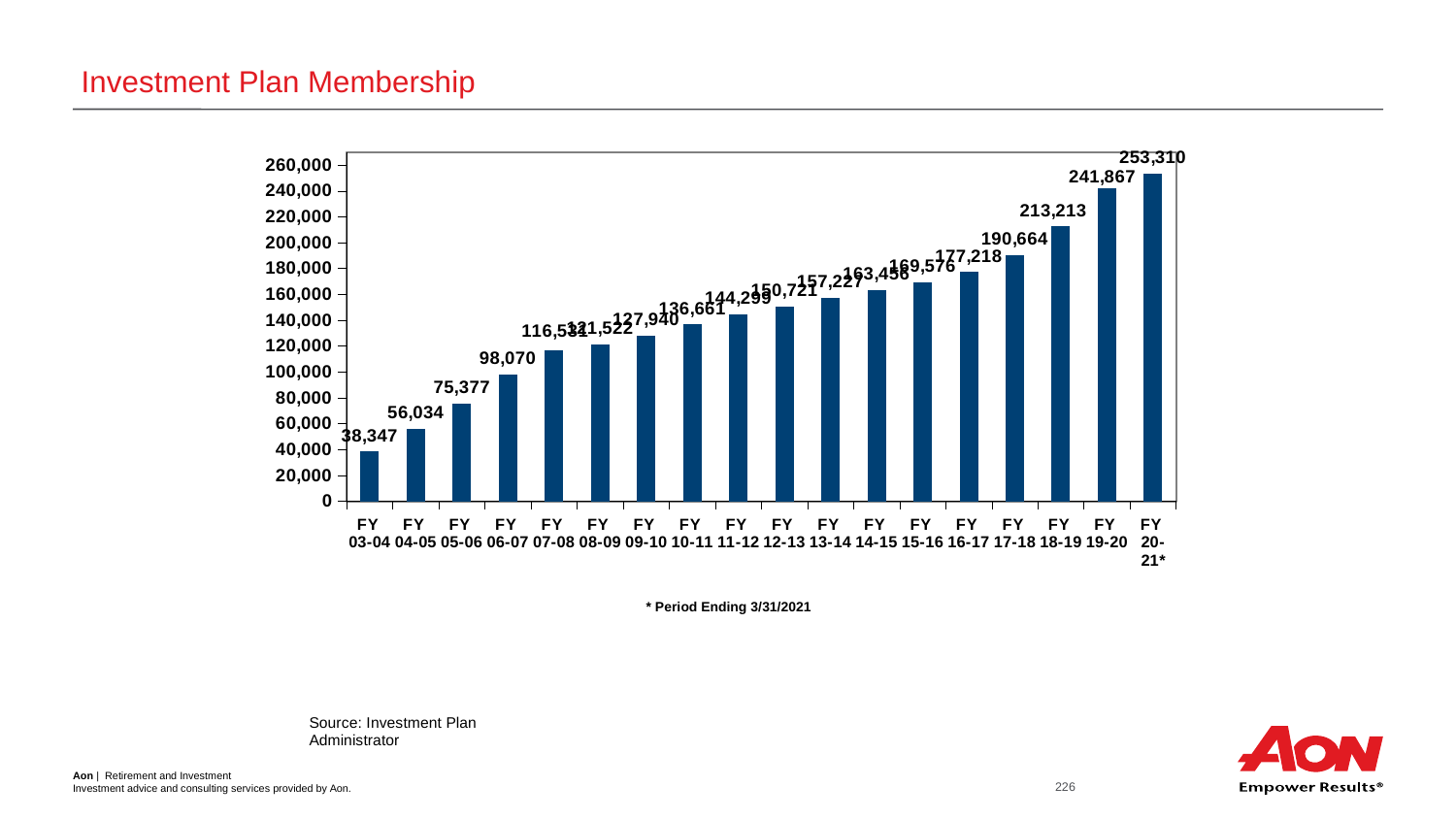
Which fiscal year has the highest membership? FY 20-21* What is the difference in membership between FY 18-19 and FY 17-18? 22,549 What is the membership value for FY 06-07? 98,070 Do membership values rise or fall across the fiscal years from left to right? rise By how much did membership increase from FY 19-20 to FY 20-21*? 11,443 Is the membership value for FY 13-14 greater or less than 140,000? greater What is the membership value for FY 19-20? 241,867 What is the membership value for FY 04-05? 56,034 Which fiscal year has the lowest membership? FY 03-04 How many fiscal years are plotted in the Investment Plan Membership chart? 18 What kind of chart is shown on the slide? bar chart What is the membership value for FY 18-19? 213,213